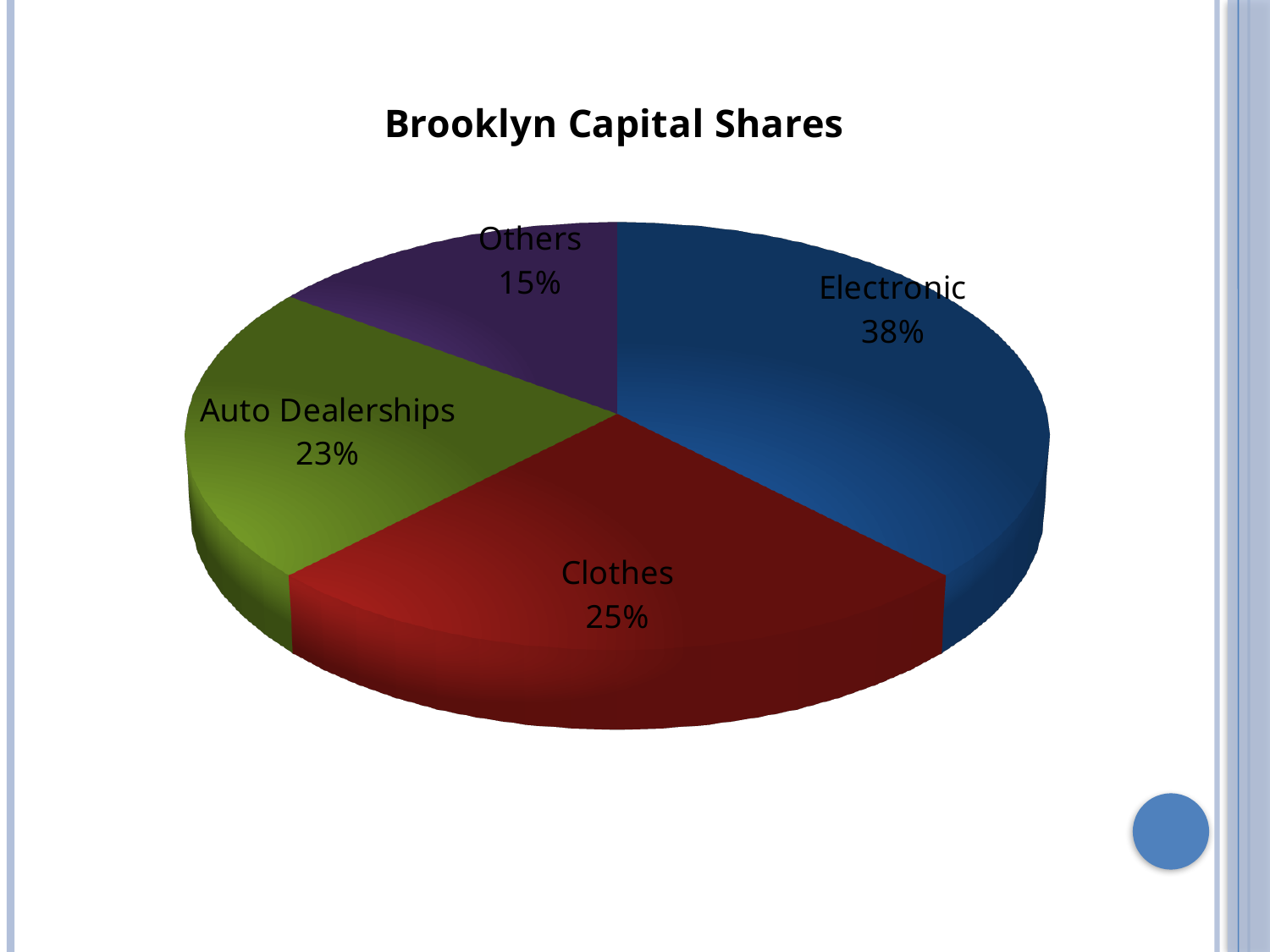
Which category has the largest slice of the pie? Electronic How many categories are shown in the pie chart? 4 What is the difference in percentage points between Electronic and Clothes? 13 What is the title of the chart? Brooklyn Capital Shares Which category has the smallest slice of the pie? Others What share of the pie does Electronic hold? 38% What is the difference in percentage points between Auto Dealerships and Others? 8 What share of the pie does Auto Dealerships hold? 23% What kind of chart is shown on the slide? Pie chart What share of the pie does Clothes hold? 25% Which is larger, the share for Clothes or the share for Auto Dealerships? Clothes